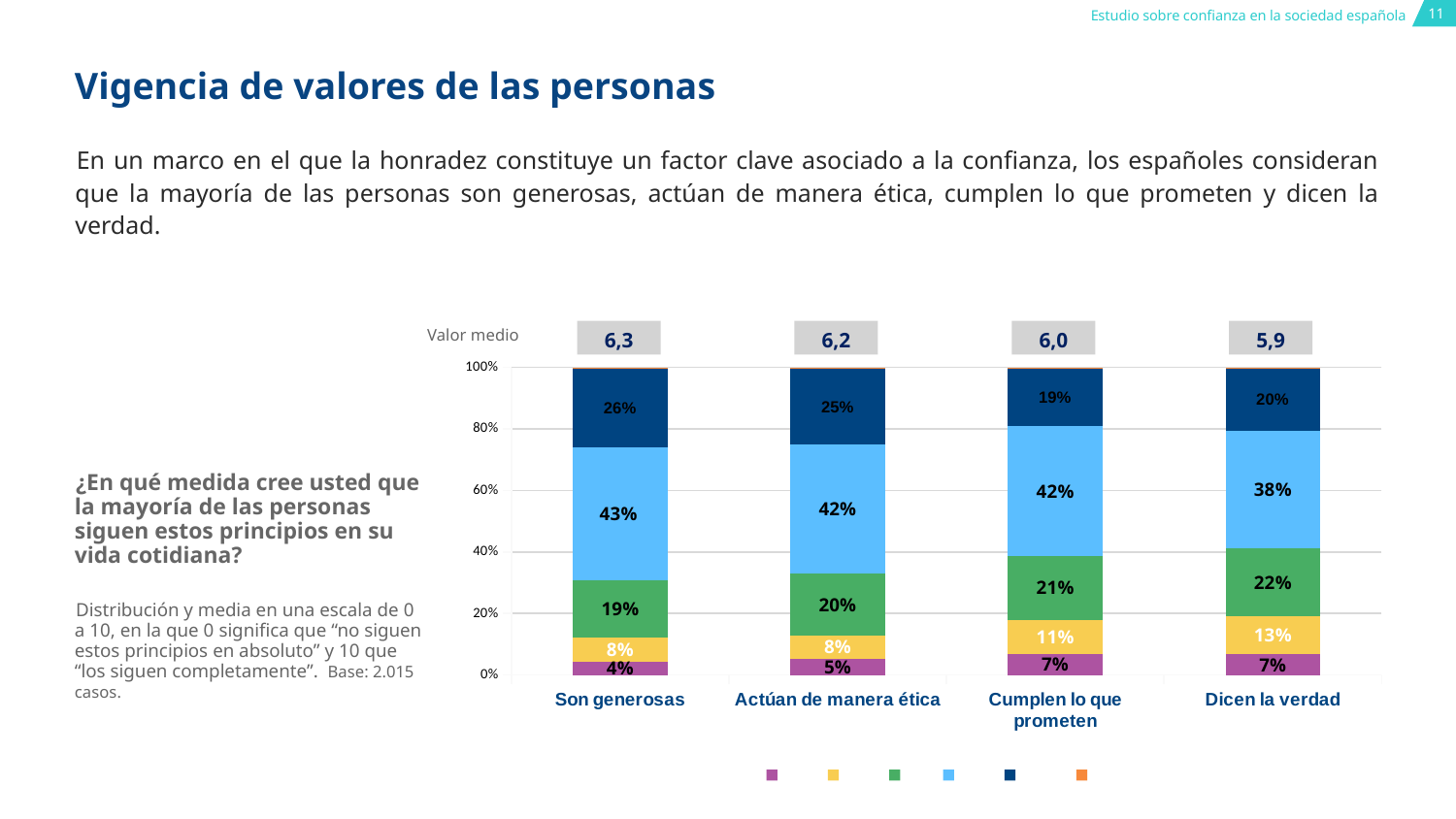
What type of chart is shown on the slide? stacked bar chart What is the total of the stacked bar for 'Cumplen lo que prometen' (7% + 11% + 21% + 42% + 19%)? 100% What is the value of the dark blue (top) segment in the bar for 'Son generosas'? 26% What is the difference between the light blue segment for 'Son generosas' (43%) and the light blue segment for 'Dicen la verdad' (38%)? 5% How many categories are shown along the x axis of the chart? 4 Which is larger: the green segment for 'Dicen la verdad' or the green segment for 'Son generosas'? Dicen la verdad What is the 'Valor medio' shown above the bar for 'Dicen la verdad'? 5,9 What is the value of the light blue segment in the bar for 'Cumplen lo que prometen'? 42% What is the value of the purple (bottom) segment in the bar for 'Actúan de manera ética'? 5% Which category has the highest 'Valor medio'? Son generosas Which category has the lowest 'Valor medio'? Dicen la verdad What is the 'Valor medio' shown above the bar for 'Son generosas'? 6,3